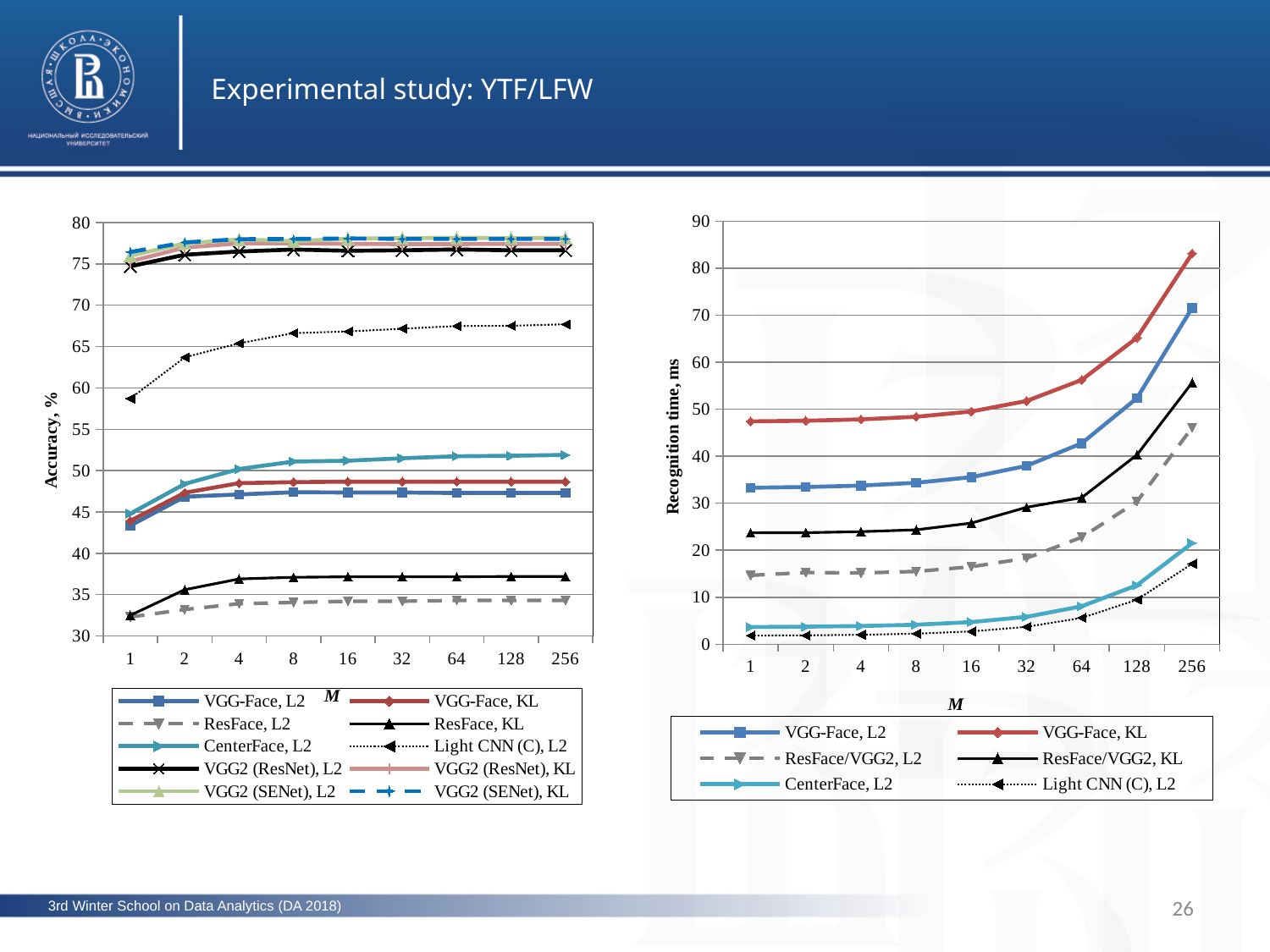
In the left chart (Accuracy, %), is the accuracy of CenterFace, L2 at M=256 greater or less than 50? greater How many series does the legend of the left chart (Accuracy, %) list? 10 In the right chart (Recognition time, ms), is the recognition time of VGG-Face, L2 at M=256 greater or less than 70? greater In the right chart (Recognition time, ms), which series has the lowest recognition time at M=256? Light CNN (C), L2 In the right chart (Recognition time, ms), which series has the highest recognition time at M=256? VGG-Face, KL How many series does the legend of the right chart (Recognition time, ms) list? 6 How many values of M are plotted along the x axis of the right chart (Recognition time, ms)? 9 What kind of chart is the left chart (Accuracy, %)? line chart In the left chart (Accuracy, %), which series has the lowest accuracy across all values of M? ResFace, L2 In the right chart (Recognition time, ms), does the recognition time of VGG-Face, KL rise or fall as M increases? rise In the right chart (Recognition time, ms), which has the larger recognition time at M=64: VGG-Face, KL or ResFace/VGG2, KL? VGG-Face, KL In the left chart (Accuracy, %), is the accuracy of Light CNN (C), L2 at M=1 greater or less than 60? less